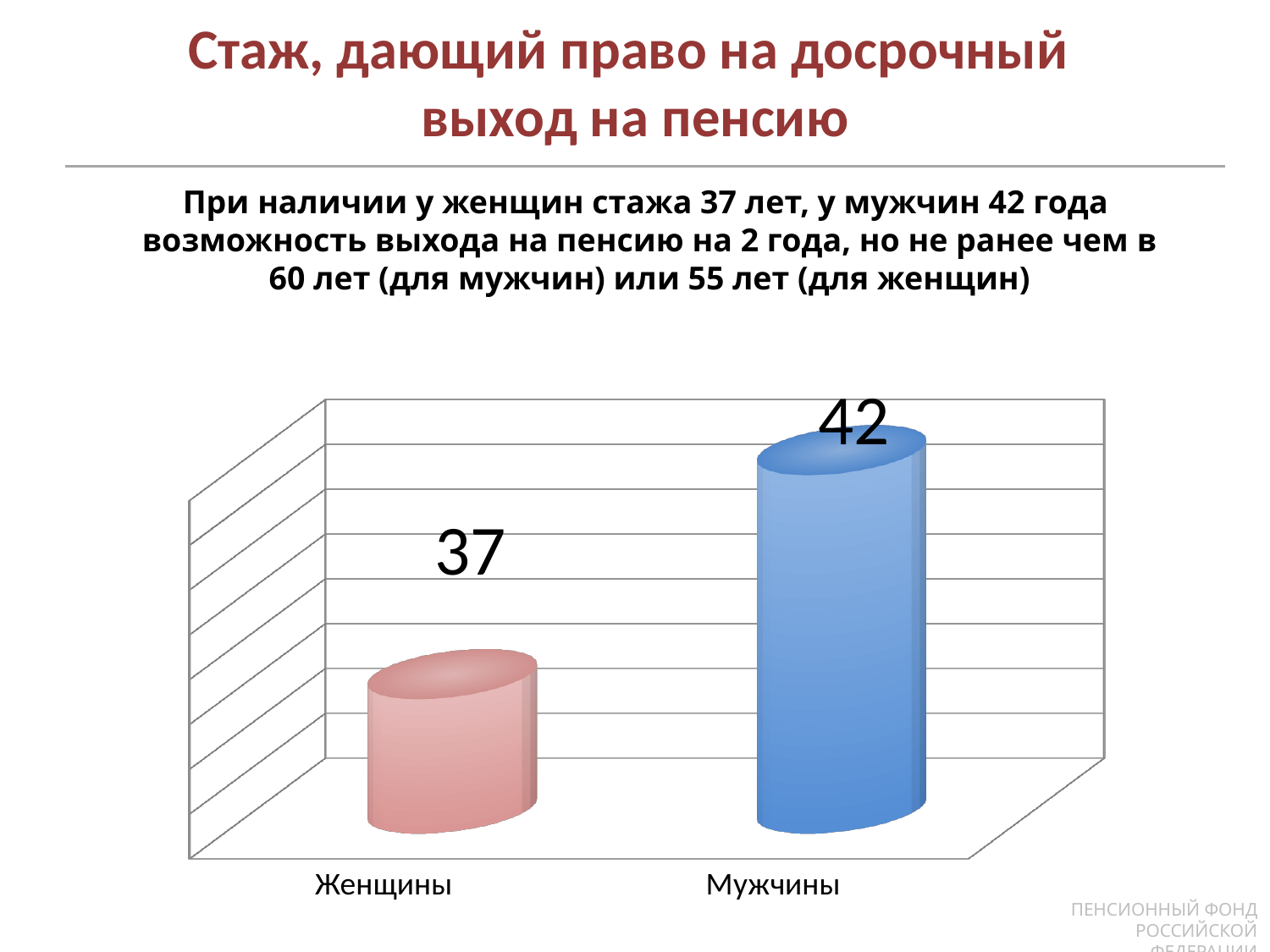
Which category has the highest value? Мужчины How many categories are shown in the chart? 2 What colour is the bar for Мужчины? Blue What kind of chart is shown on the slide? Bar chart Which category has the lowest value? Женщины What is the difference between the values for Мужчины and Женщины? 5 What colour is the bar for Женщины? Pink What is the value shown for Мужчины? 42 Which is larger, the value for Женщины or the value for Мужчины? Мужчины What is the value shown for Женщины? 37